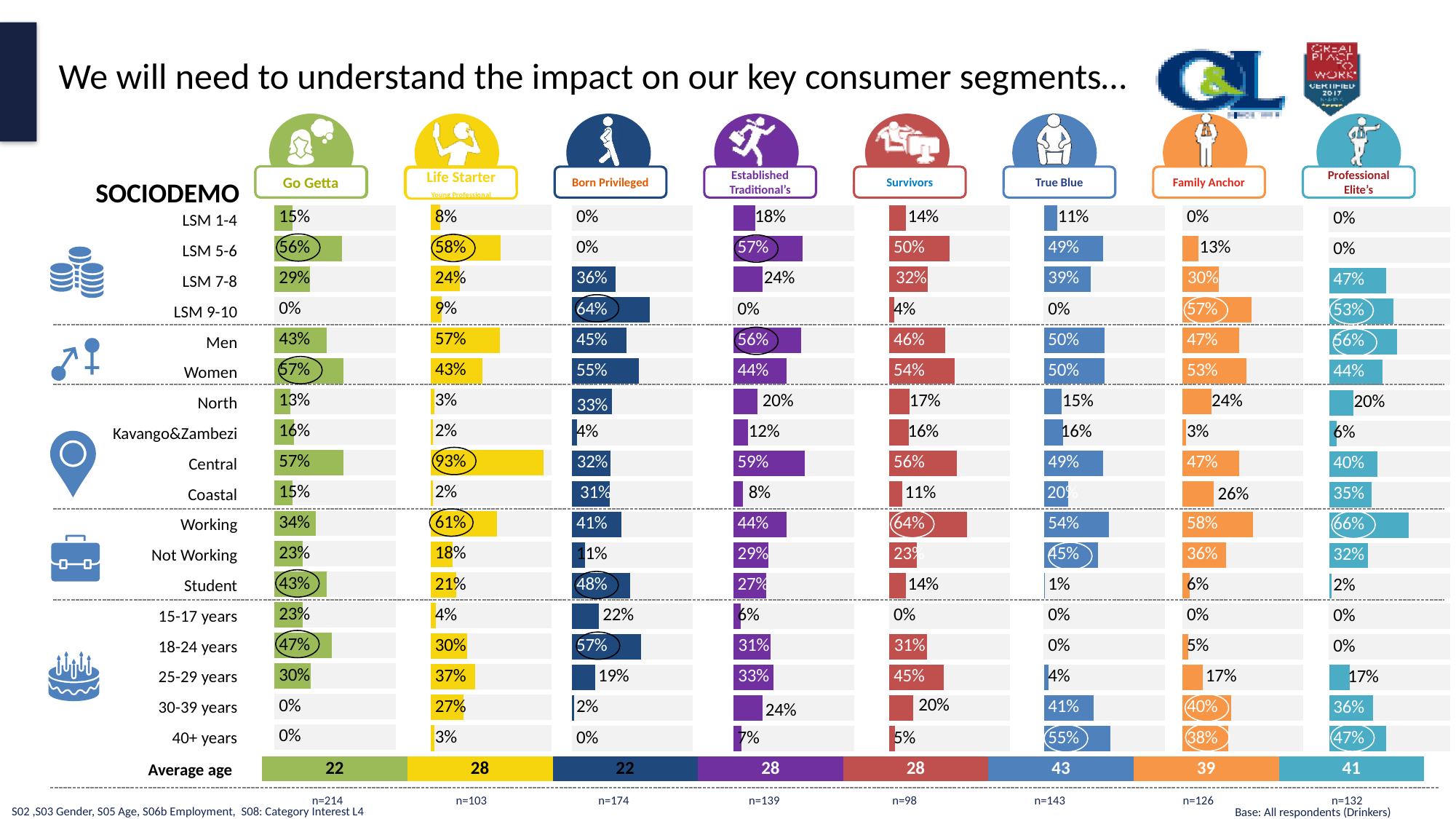
In the True Blue chart, what percentage is shown for 40+ years? 55% How many consumer segments are shown across the slide? 8 In the Born Privileged chart, which age group has the lowest value? 40+ years What is the average age shown for the True Blue segment? 43 Which consumer segment has the highest Student percentage? Born Privileged In the Established Traditional's chart, what percentage is shown for LSM 5-6? 57% For the Working row, which is larger: the Life Starter value or the Born Privileged value? Life Starter In the Survivors chart, which region row has the highest value? Central What kind of chart is used to show the sociodemographic percentages? Bar chart In the Go Getta chart, what is the difference between the Women and Men percentages? 14 percentage points In the Family Anchor chart, what percentage is shown for 30-39 years? 40% In the Life Starter chart, what percentage is shown for the Central region? 93%